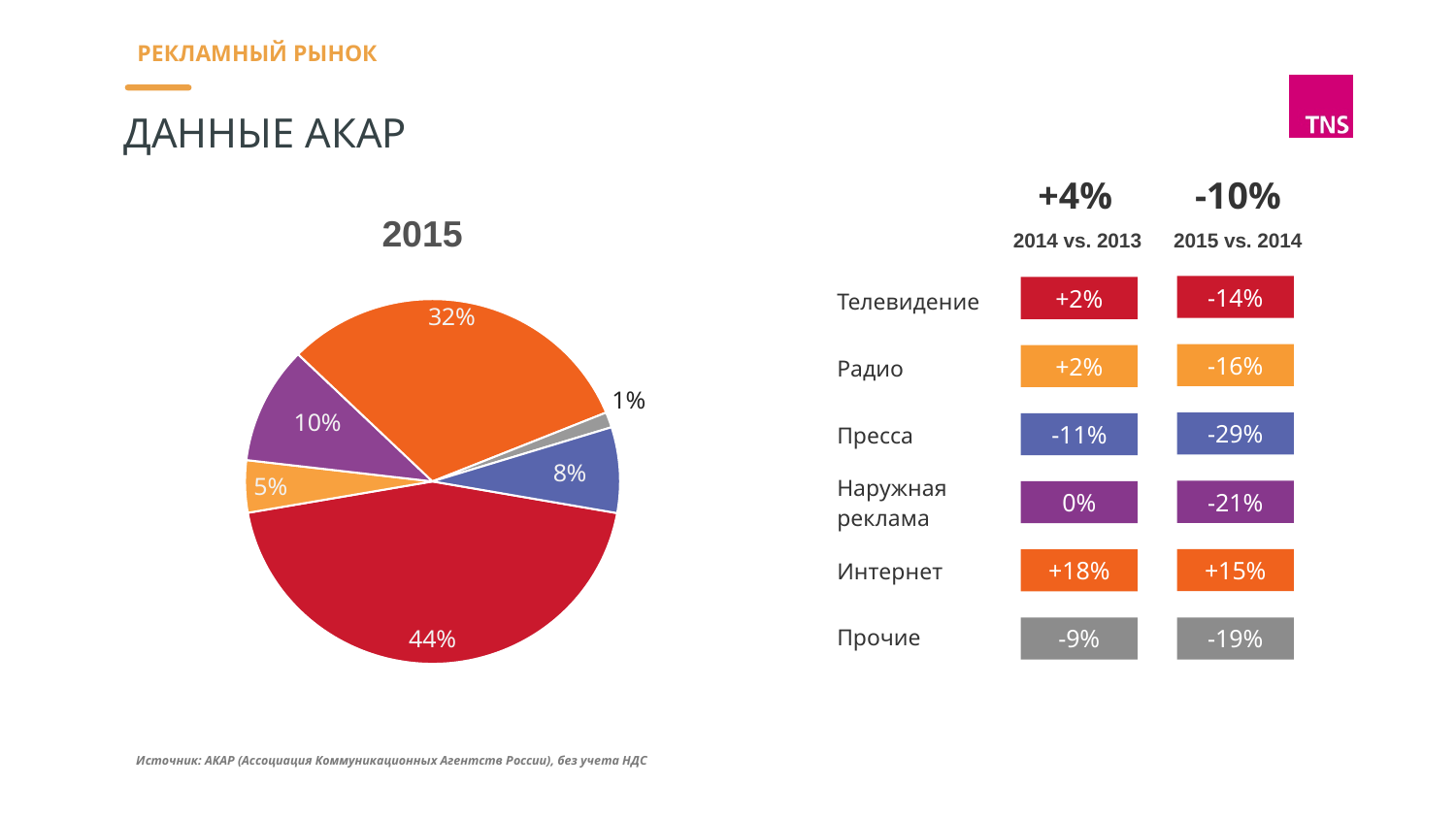
What share does the blue slice of the pie chart represent? 8% What is the difference between the largest slice (44%) and the second largest slice (32%) in the pie chart? 12 percentage points How many slices does the pie chart have? 6 What is the value of the largest slice in the pie chart? 44% What share does the purple slice of the pie chart represent? 10% What kind of chart is shown on the slide? Pie chart What is the title of the pie chart? 2015 What is the value of the smallest slice in the pie chart? 1% What share does the orange slice of the pie chart represent? 32% What do the red and orange slices of the pie chart add up to? 76% Which slice is larger in the pie chart, the purple one or the blue one? The purple one (10%) What share does the red slice of the pie chart represent? 44%